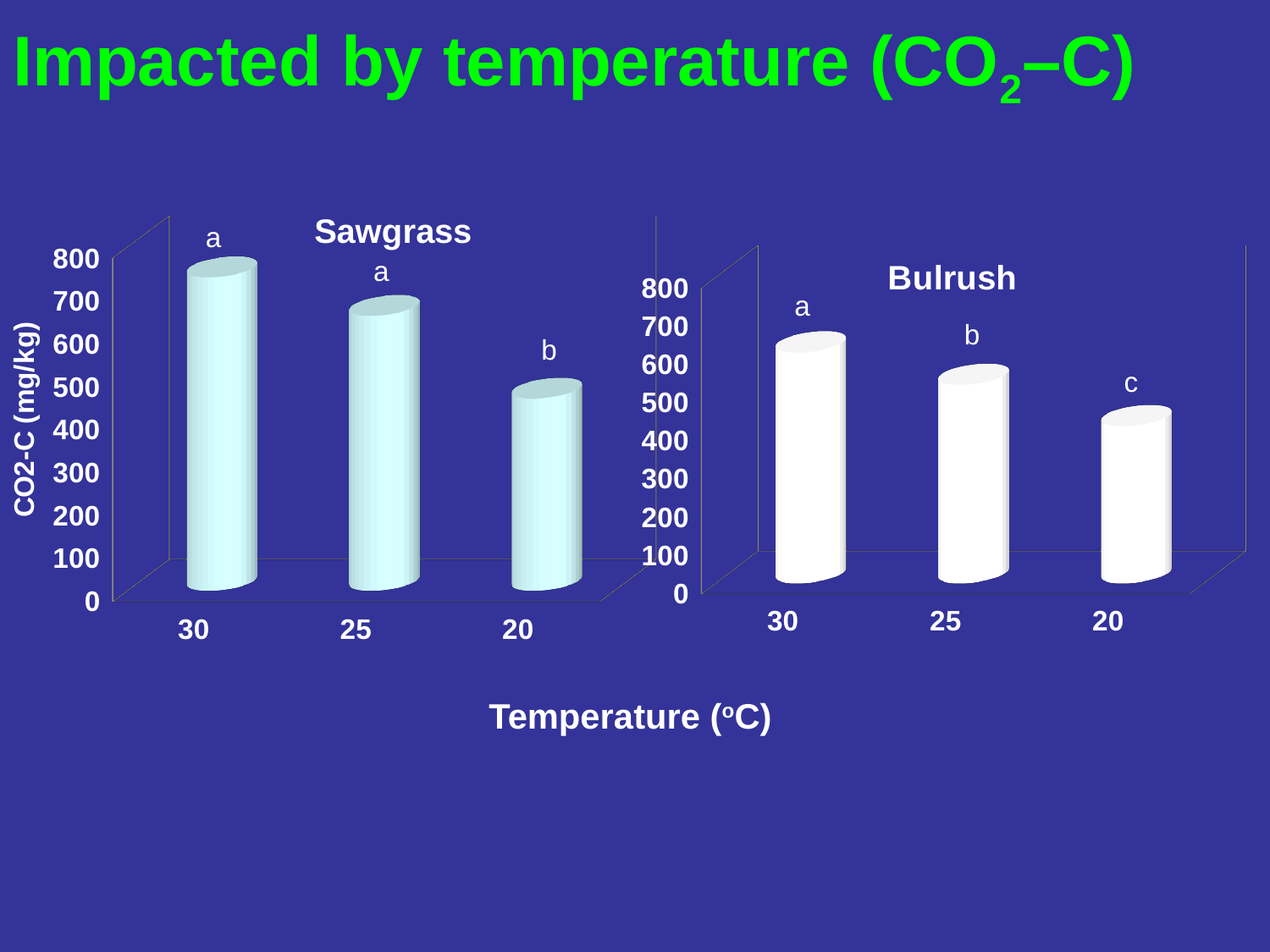
In the Bulrush chart, which is larger, the value for 30 or the value for 20? 30 In the Sawgrass chart, is the value for 30 greater or less than 700? greater In the Bulrush chart, which temperature has the highest CO2-C value? 30 How many bars are in the Sawgrass chart? 3 In the Bulrush chart, which temperature has the lowest CO2-C value? 20 What kind of chart is the Sawgrass chart? bar chart In the Bulrush chart, is the value for 20 greater or less than 600? less In the Sawgrass chart, which temperature has the lowest CO2-C value? 20 In the Sawgrass chart, is the value for 20 greater or less than 600? less In the Bulrush chart, do the values rise or fall from left to right along the x axis? fall In the Sawgrass chart, which temperature has the highest CO2-C value? 30